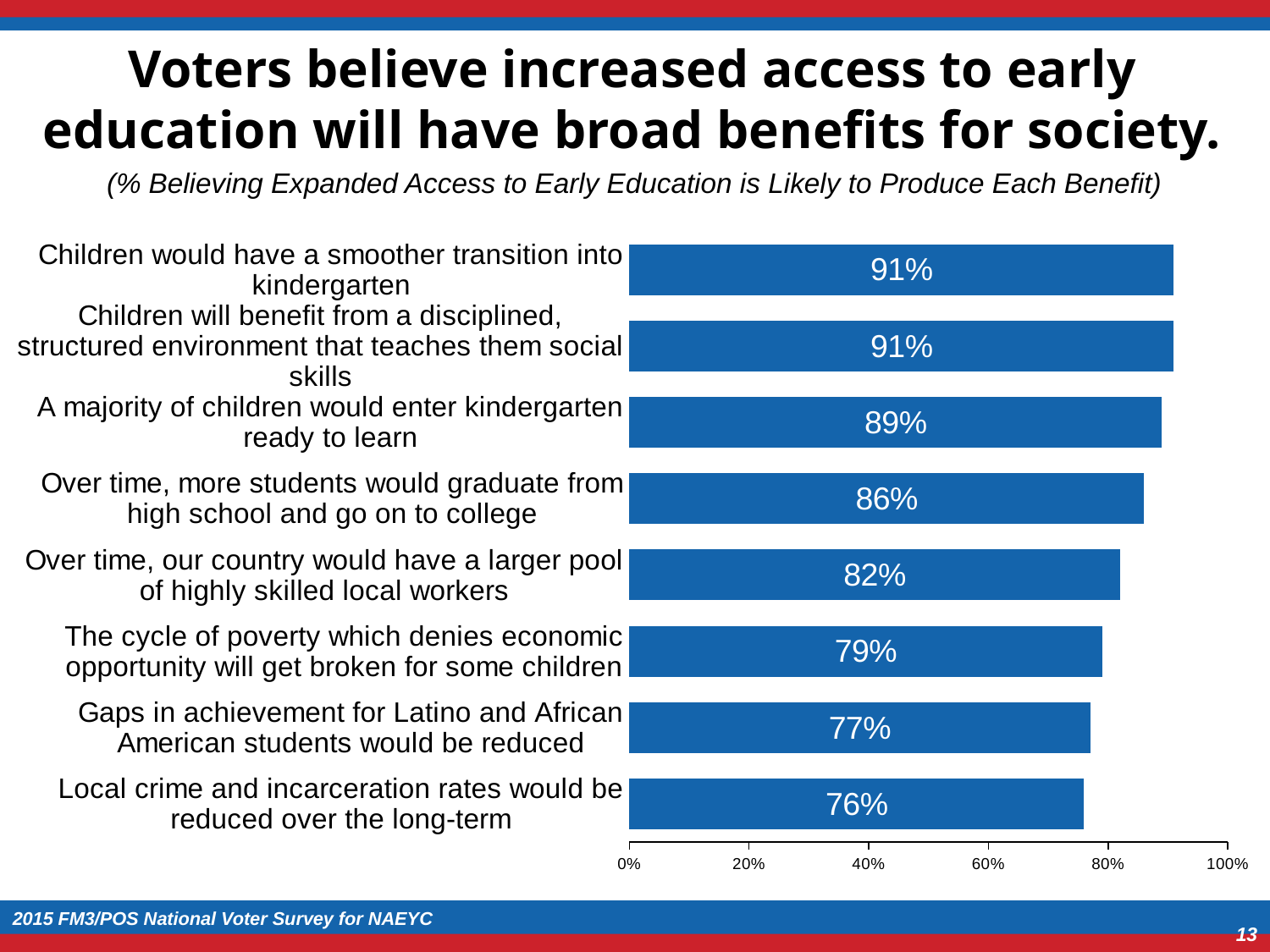
What kind of chart is shown on the slide? Bar chart What is the value for 'Gaps in achievement for Latino and African American students would be reduced'? 77% Which benefit has the lowest percentage on the chart? Local crime and incarceration rates would be reduced over the long-term What is the difference between the value for 'A majority of children would enter kindergarten ready to learn' and the value for 'The cycle of poverty which denies economic opportunity will get broken for some children'? 10% What percentage believe that over time, more students would graduate from high school and go on to college? 86% Is the value for 'The cycle of poverty which denies economic opportunity will get broken for some children' greater or less than 60%? greater Do the values rise or fall going from the top bar to the bottom bar? Fall What percentage of voters believe children would have a smoother transition into kindergarten? 91% What is the highest value shown on the horizontal axis? 100% How many benefits (categories) are shown on the chart? 8 Which is larger: the value for 'Over time, our country would have a larger pool of highly skilled local workers' or the value for 'Gaps in achievement for Latino and African American students would be reduced'? Over time, our country would have a larger pool of highly skilled local workers What is the value for 'Local crime and incarceration rates would be reduced over the long-term'? 76%